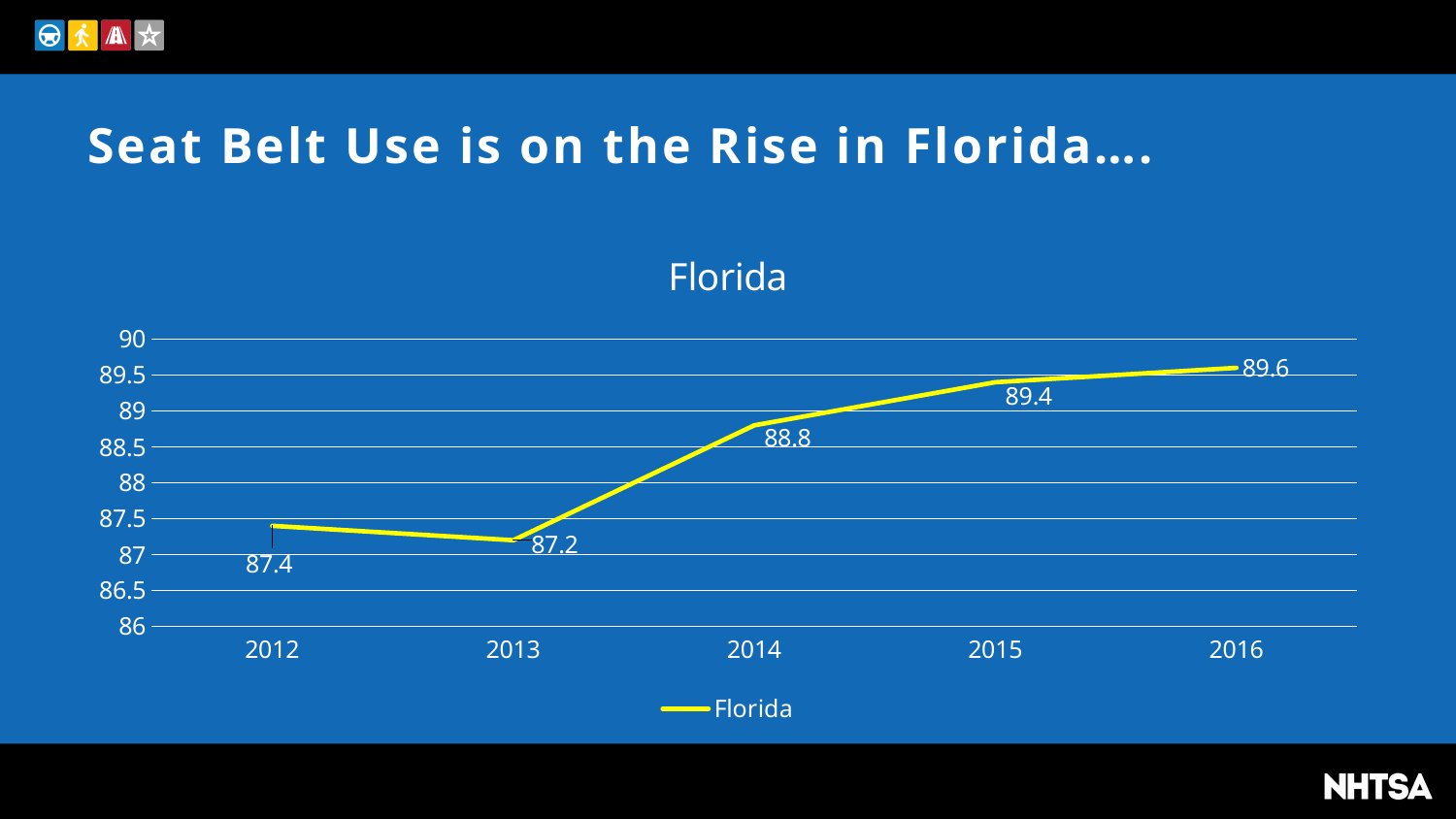
What kind of chart is shown? line chart Is the value for 2015 greater or less than 89? greater What is the value for Florida in 2012? 87.4 What is the difference between the 2014 value and the 2013 value? 1.6 What is the value for Florida in 2014? 88.8 Which is larger, the value for 2015 or the value for 2013? 2015 What is the value for Florida in 2016? 89.6 Which year has the highest value? 2016 What is the difference between the 2016 value and the 2012 value? 2.2 Which year has the lowest value? 2013 Do the values generally rise or fall from 2013 to 2016? rise How many years are plotted on the x axis? 5